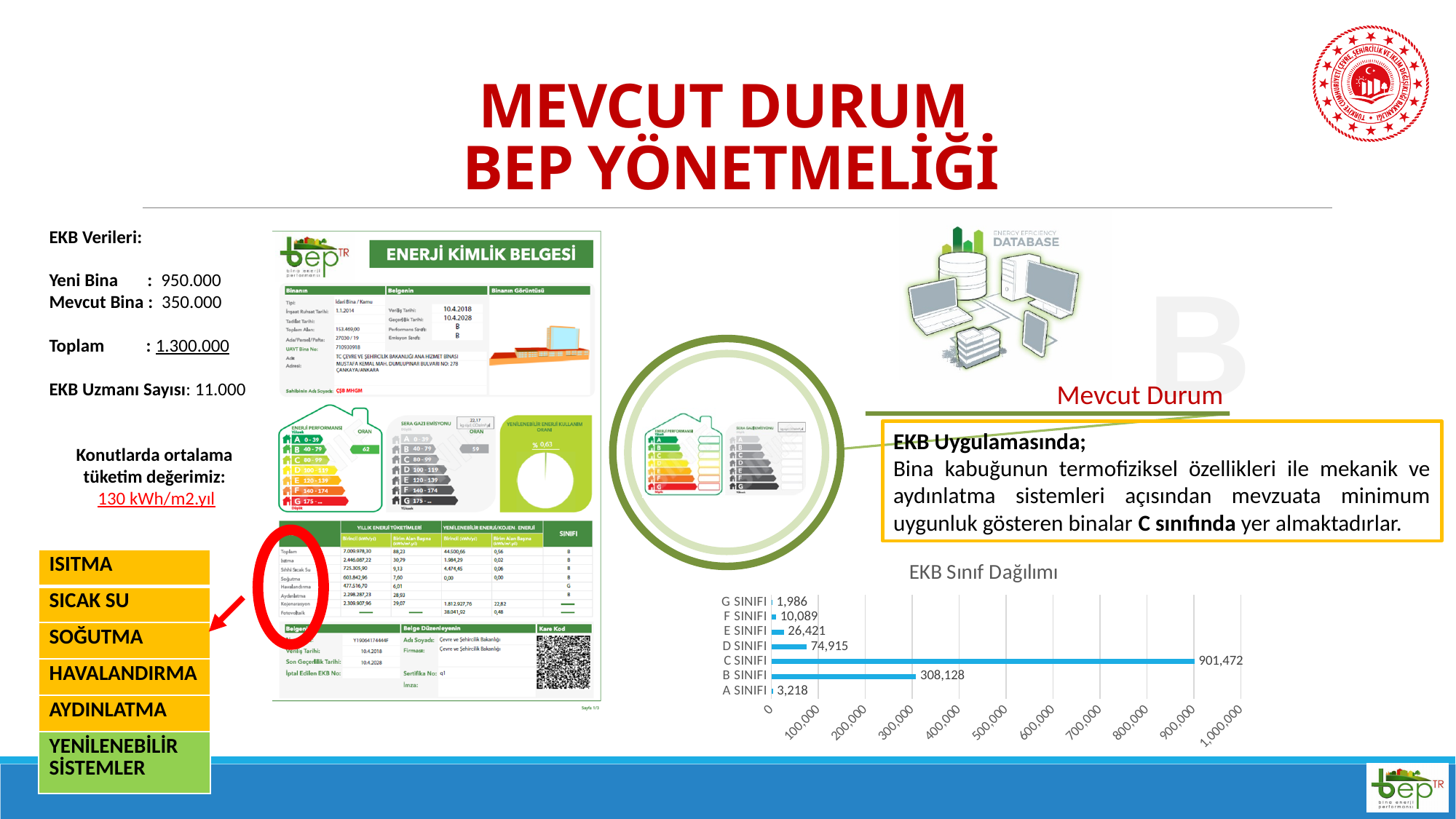
Which category has the highest value in the EKB Sınıf Dağılımı chart? C SINIFI What is the value for D SINIFI in the EKB Sınıf Dağılımı chart? 74,915 Which category has the lowest value in the EKB Sınıf Dağılımı chart? G SINIFI What is the difference between the values for C SINIFI and B SINIFI in the EKB Sınıf Dağılımı chart? 593,344 Is the value for B SINIFI in the EKB Sınıf Dağılımı chart greater or less than 200,000? greater Which is larger in the EKB Sınıf Dağılımı chart, E SINIFI or F SINIFI? E SINIFI What is the value for C SINIFI in the EKB Sınıf Dağılımı chart? 901,472 What kind of chart is the EKB Sınıf Dağılımı chart? bar chart What is the value for B SINIFI in the EKB Sınıf Dağılımı chart? 308,128 What is the title of the chart on the slide? EKB Sınıf Dağılımı What is the value for A SINIFI in the EKB Sınıf Dağılımı chart? 3,218 How many categories are shown in the EKB Sınıf Dağılımı chart? 7